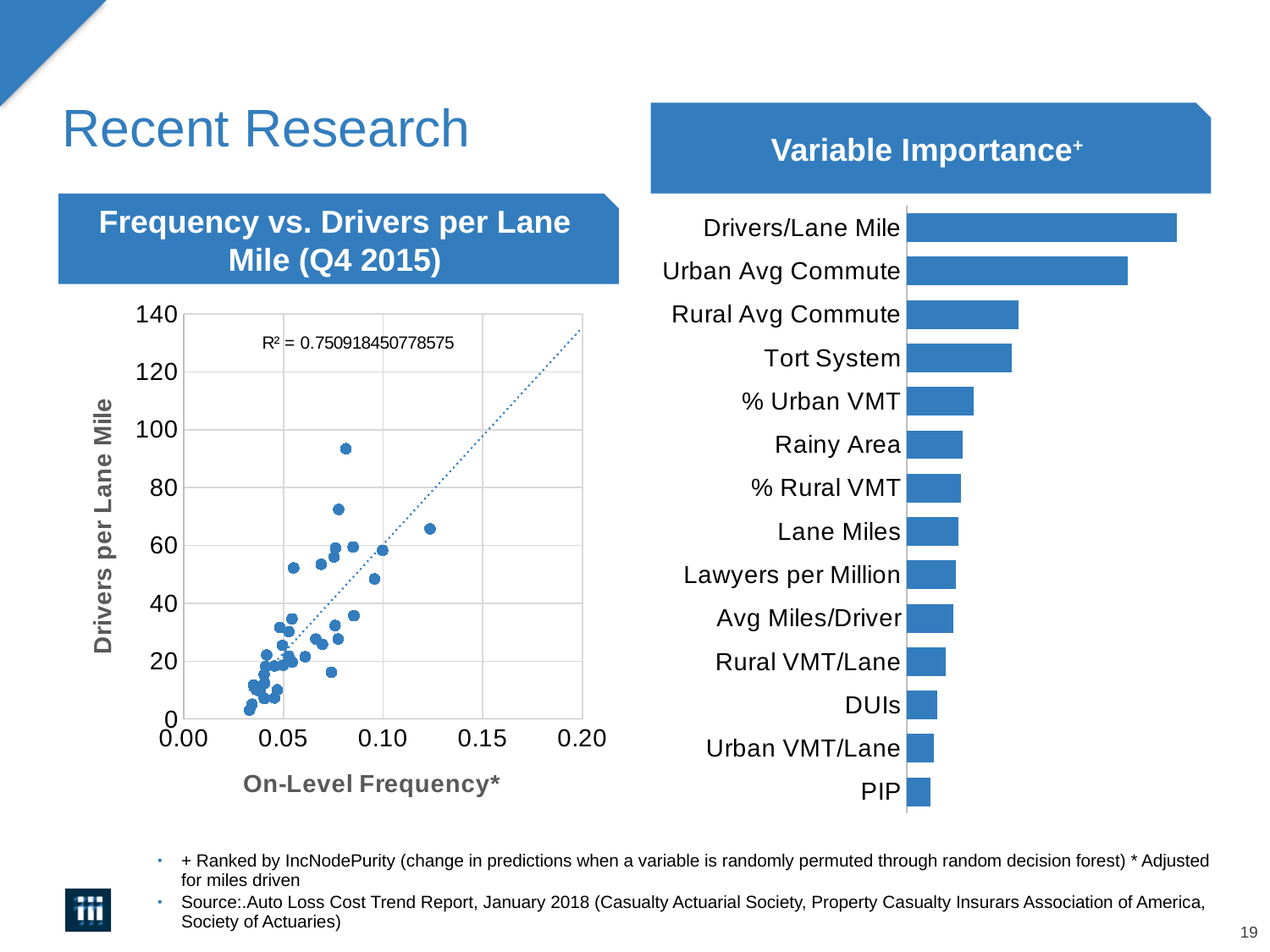
How many variables are listed in the 'Variable Importance' chart? 14 What kind of chart is the 'Frequency vs. Drivers per Lane Mile (Q4 2015)' chart on the left of the slide? scatter chart In the 'Variable Importance' chart, which has the larger bar: Urban Avg Commute or Rural Avg Commute? Urban Avg Commute What kind of chart is the 'Variable Importance' chart on the right of the slide? bar chart In the 'Variable Importance' chart, which has the larger bar: Tort System or % Urban VMT? Tort System In the 'Variable Importance' chart, which variable has the lowest importance? PIP In the 'Frequency vs. Drivers per Lane Mile (Q4 2015)' chart, what R² value is printed on the chart? R² = 0.750918450778575 In the 'Frequency vs. Drivers per Lane Mile (Q4 2015)' chart, what is the label of the y axis? Drivers per Lane Mile In the 'Variable Importance' chart, which variable is ranked second highest? Urban Avg Commute In the 'Variable Importance' chart, which variable has the highest importance? Drivers/Lane Mile In the 'Frequency vs. Drivers per Lane Mile (Q4 2015)' chart, is the highest plotted point's Drivers per Lane Mile value greater or less than 80? greater In the 'Frequency vs. Drivers per Lane Mile (Q4 2015)' chart, do the values of Drivers per Lane Mile generally rise or fall as On-Level Frequency increases? rise